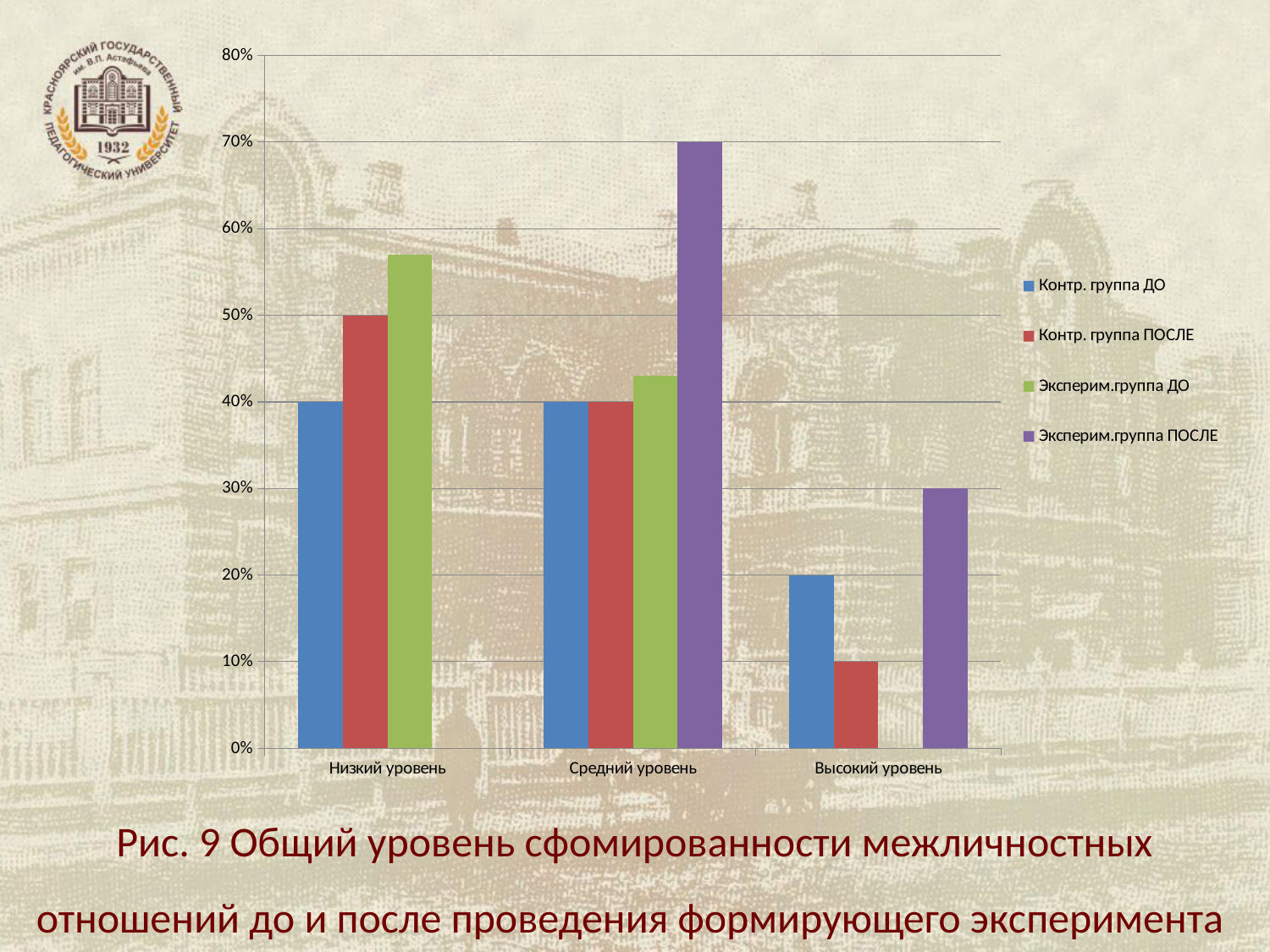
Which series has the lowest value in the Высокий уровень category? Эксперим.группа ДО What is the value for Эксперим.группа ПОСЛЕ in the Низкий уровень category? 0% How many categories are shown on the x axis? 3 How many series does the legend list? 4 What is the value for Контр. группа ПОСЛЕ in the Высокий уровень category? 10% Is the value for Эксперим.группа ДО in the Низкий уровень category greater or less than 50%? greater Which is larger in the Высокий уровень category: Контр. группа ДО or Эксперим.группа ПОСЛЕ? Эксперим.группа ПОСЛЕ Which series has the highest value in the Низкий уровень category? Эксперим.группа ДО What is the difference between Контр. группа ПОСЛЕ and Контр. группа ДО in the Низкий уровень category? 10% What is the value for Эксперим.группа ПОСЛЕ in the Высокий уровень category? 30% What kind of chart is shown on the slide? bar chart What is the value for Контр. группа ДО in the Низкий уровень category? 40%